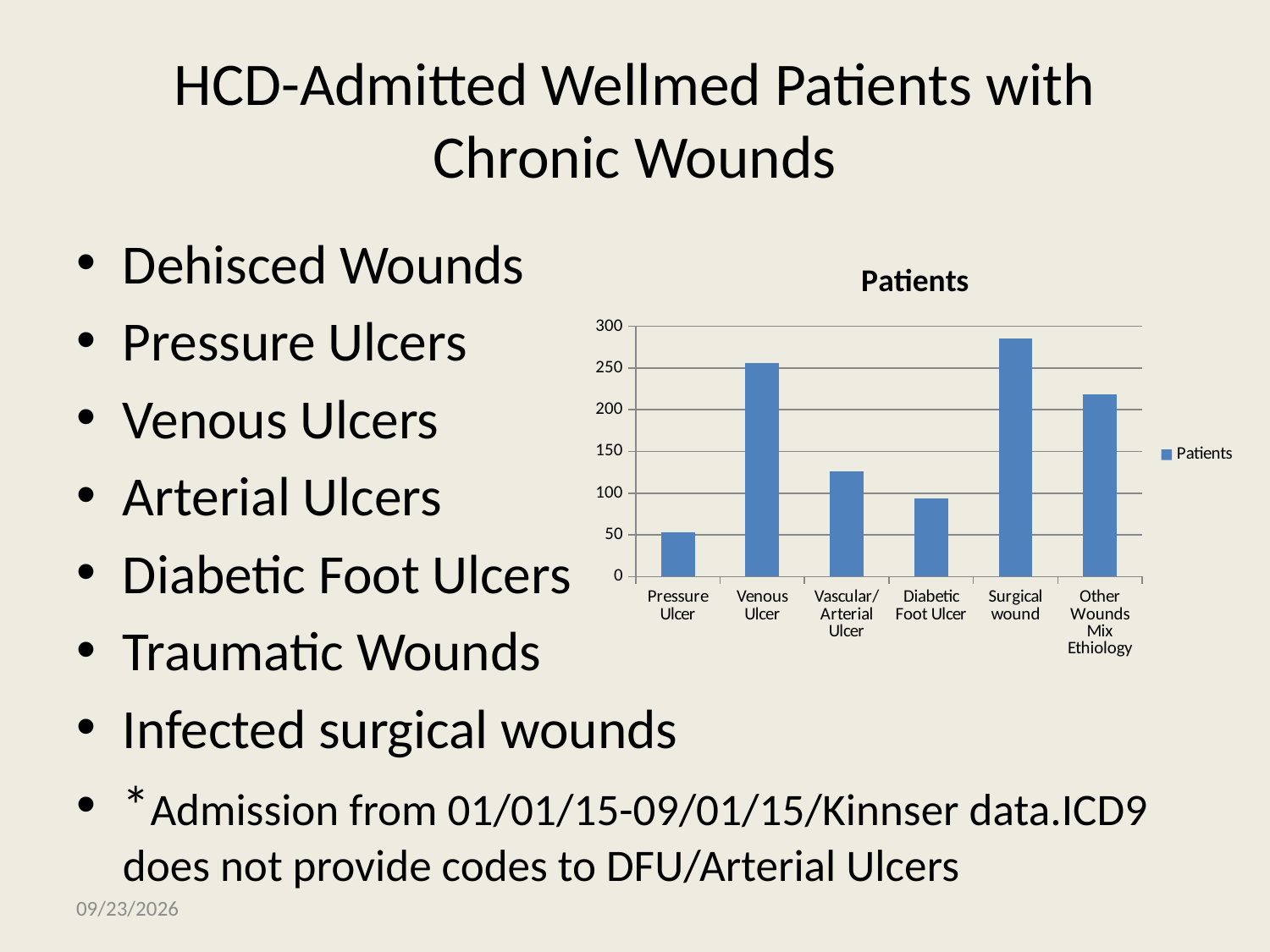
What is the name of the series shown in the chart legend? Patients Which category has the highest number of patients? Surgical wound Is the value for Diabetic Foot Ulcer greater or less than 100? less Which has more patients, Venous Ulcer or Vascular/Arterial Ulcer? Venous Ulcer Is the value for Pressure Ulcer greater or less than 100? less How many categories are shown on the x axis of the chart? 6 What kind of chart is shown on the slide? bar chart Which category has the lowest number of patients? Pressure Ulcer What is the title of the chart? Patients Is the value for Venous Ulcer greater or less than 200? greater Which has more patients, Diabetic Foot Ulcer or Other Wounds Mix Ethiology? Other Wounds Mix Ethiology How many series does the chart legend list? 1